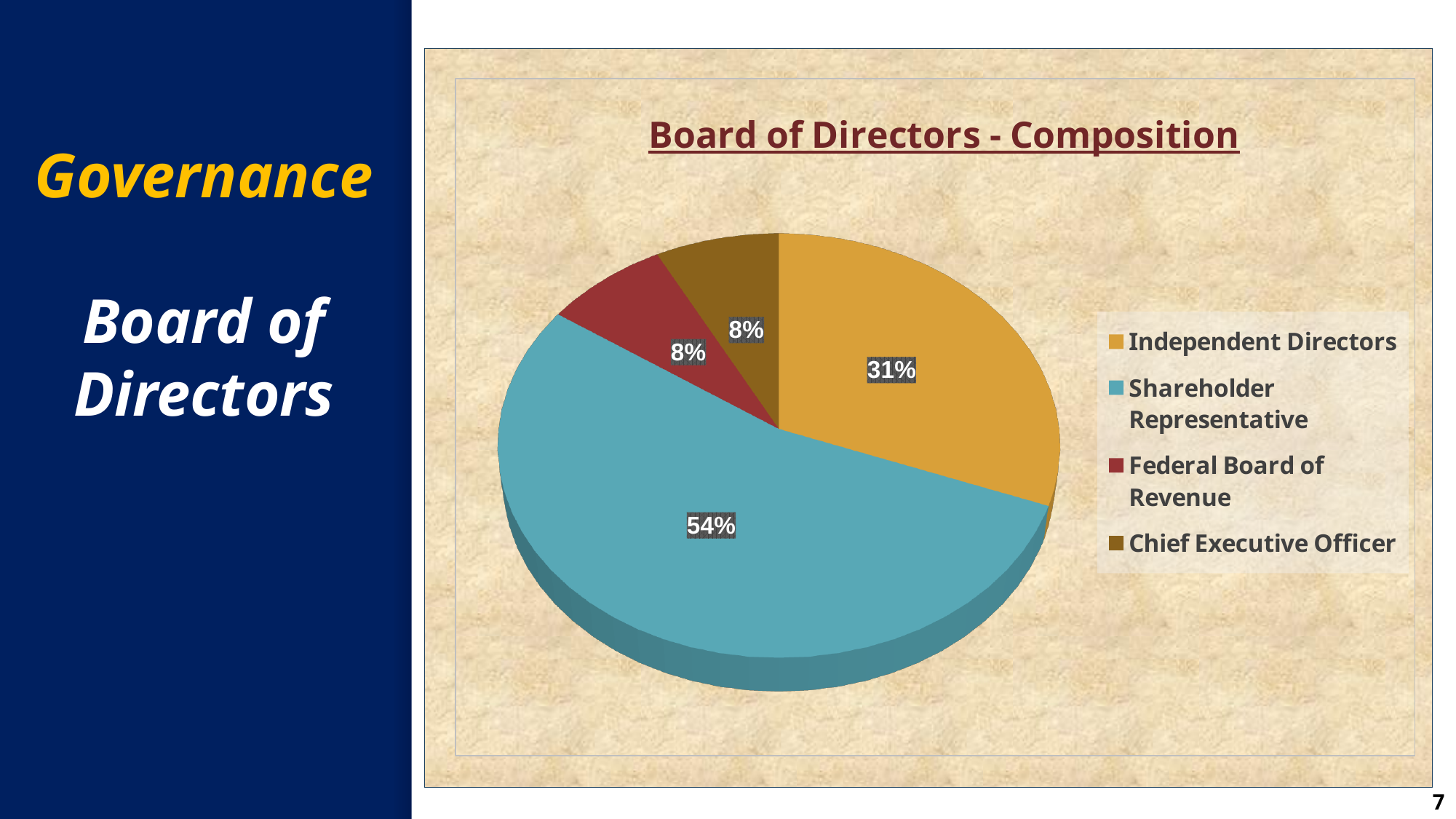
What colour is the Shareholder Representative slice? Blue Which category has the largest slice of the pie? Shareholder Representative What share of the pie does Independent Directors hold? 31% How many categories does the pie chart show? 4 What is the difference between the Shareholder Representative share and the Independent Directors share? 23 percentage points What share of the pie does Chief Executive Officer hold? 8% What is the combined share of Federal Board of Revenue and Chief Executive Officer? 16% What kind of chart is shown on the slide? Pie chart What share of the pie does Federal Board of Revenue hold? 8% What share of the pie does Shareholder Representative hold? 54% What is the title of the chart? Board of Directors - Composition Which is larger, the Independent Directors slice or the Federal Board of Revenue slice? Independent Directors